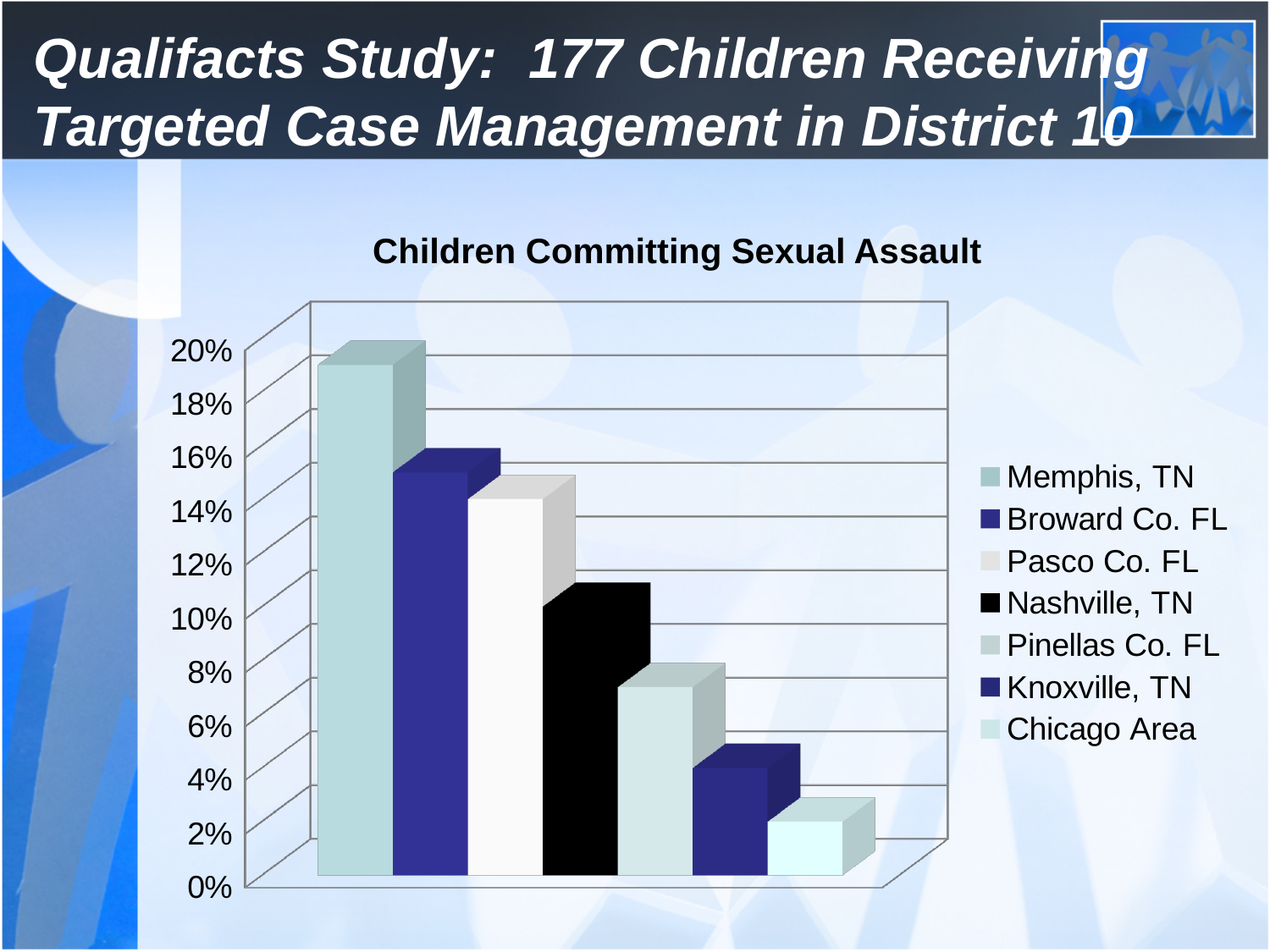
How many series does the legend list? 7 Is the value for Chicago Area greater or less than 4%? less Is the value for Memphis, TN greater or less than 18%? greater How many bars are plotted in the chart? 7 What is the title of the chart? Children Committing Sexual Assault What kind of chart is shown on the slide? bar chart Which is larger, the value for Nashville, TN or the value for Pinellas Co. FL? Nashville, TN Which location has the highest value in the chart? Memphis, TN Which location has the lowest value in the chart? Chicago Area Is the value for Nashville, TN greater or less than 12%? less Do the bar values rise or fall from left to right across the chart? fall